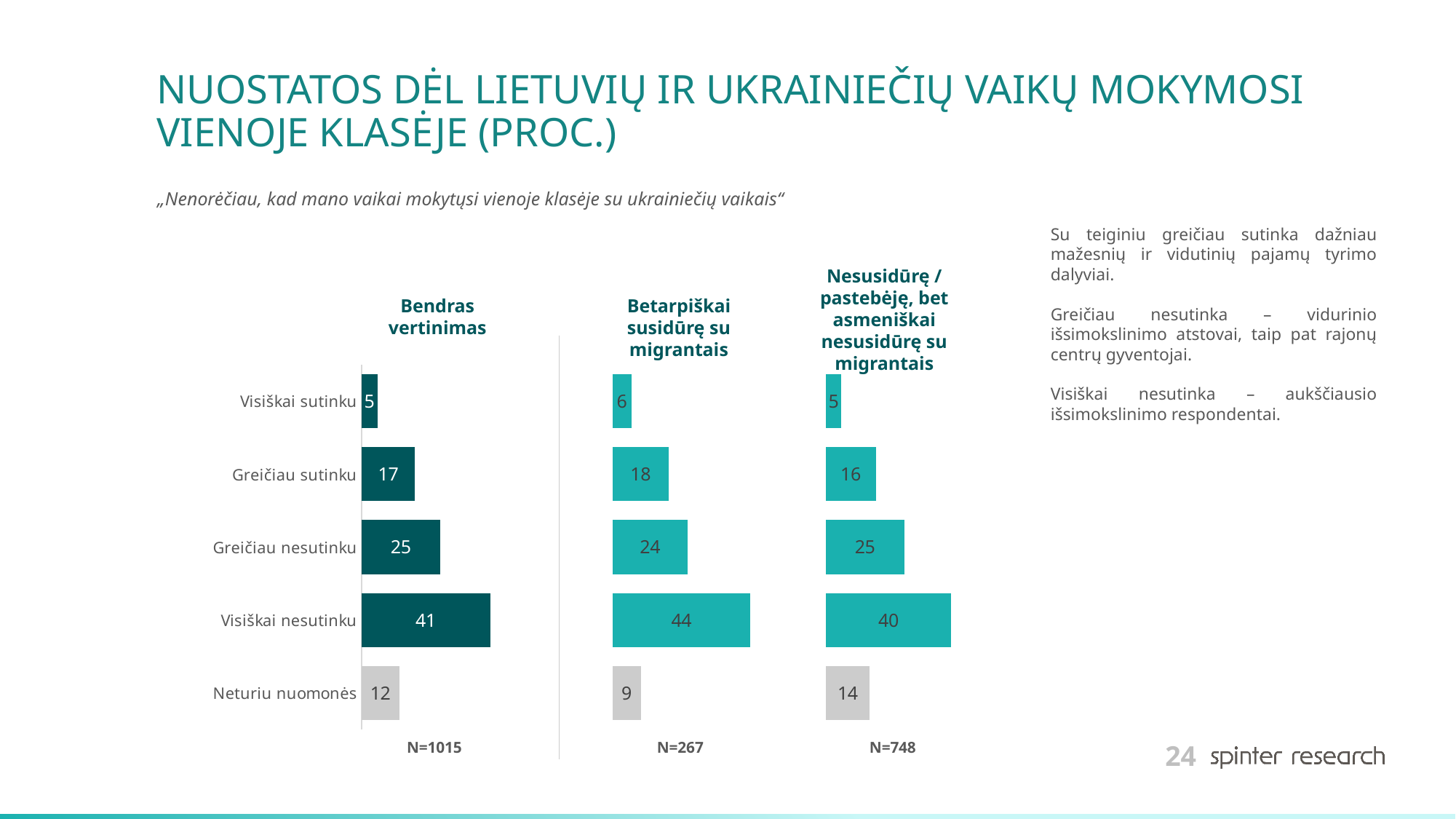
In the "Nesusidūrę / pastebėję, bet asmeniškai nesusidūrę su migrantais" chart, what is the difference between "Greičiau nesutinku" and "Greičiau sutinku"? 9 Which is larger: "Visiškai nesutinku" in the "Betarpiškai susidūrę su migrantais" chart or "Visiškai nesutinku" in the "Nesusidūrę / pastebėję, bet asmeniškai nesusidūrę su migrantais" chart? Betarpiškai susidūrę su migrantais In the "Bendras vertinimas" chart, which category has the highest value? Visiškai nesutinku How many categories are shown in the "Bendras vertinimas" chart? 5 In the "Betarpiškai susidūrę su migrantais" chart, what is the value for "Greičiau sutinku"? 18 What is the sample size (N) shown under the "Betarpiškai susidūrę su migrantais" chart? N=267 How many separate bar charts are shown on the slide? 3 In the "Bendras vertinimas" chart, what is the difference between "Visiškai nesutinku" and "Greičiau nesutinku"? 16 In the "Bendras vertinimas" chart, what is the value for "Visiškai nesutinku"? 41 What type of chart is used on this slide? Bar chart In the "Nesusidūrę / pastebėję, bet asmeniškai nesusidūrę su migrantais" chart, what is the value for "Neturiu nuomonės"? 14 In the "Betarpiškai susidūrę su migrantais" chart, which category has the lowest value? Visiškai sutinku